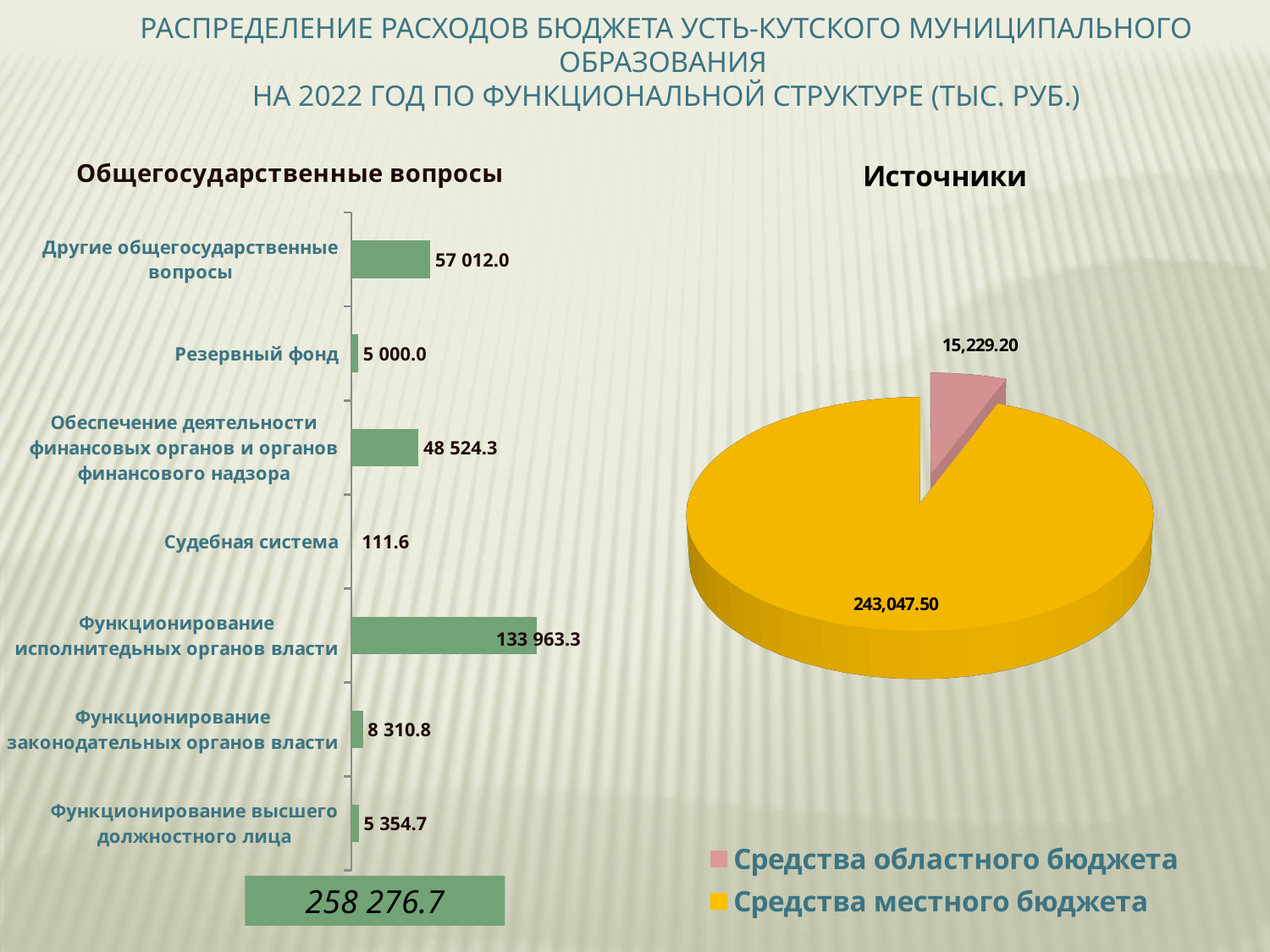
On the bar chart 'Общегосударственные вопросы', what is the difference between 'Другие общегосударственные вопросы' and 'Обеспечение деятельности финансовых органов и органов финансового надзора'? 8 487.7 How many categories are shown on the bar chart 'Общегосударственные вопросы'? 7 On the bar chart 'Общегосударственные вопросы', which is larger: 'Функционирование законодательных органов власти' or 'Функционирование высшего должностного лица'? Функционирование законодательных органов власти On the pie chart 'Источники', what share of the total does 'Средства местного бюджета' represent? 94.1% On the bar chart 'Общегосударственные вопросы', what is the value for 'Функционирование исполнительных органов власти'? 133 963.3 What type of chart is the 'Общегосударственные вопросы' chart? Bar chart On the bar chart 'Общегосударственные вопросы', which category has the highest value? Функционирование исполнительных органов власти How many entries does the legend of the pie chart 'Источники' list? 2 On the bar chart 'Общегосударственные вопросы', what is the value for 'Резервный фонд'? 5 000.0 On the bar chart 'Общегосударственные вопросы', what is the value for 'Судебная система'? 111.6 On the pie chart 'Источники', what is the value for 'Средства областного бюджета'? 15,229.20 On the bar chart 'Общегосударственные вопросы', which category has the lowest value? Судебная система